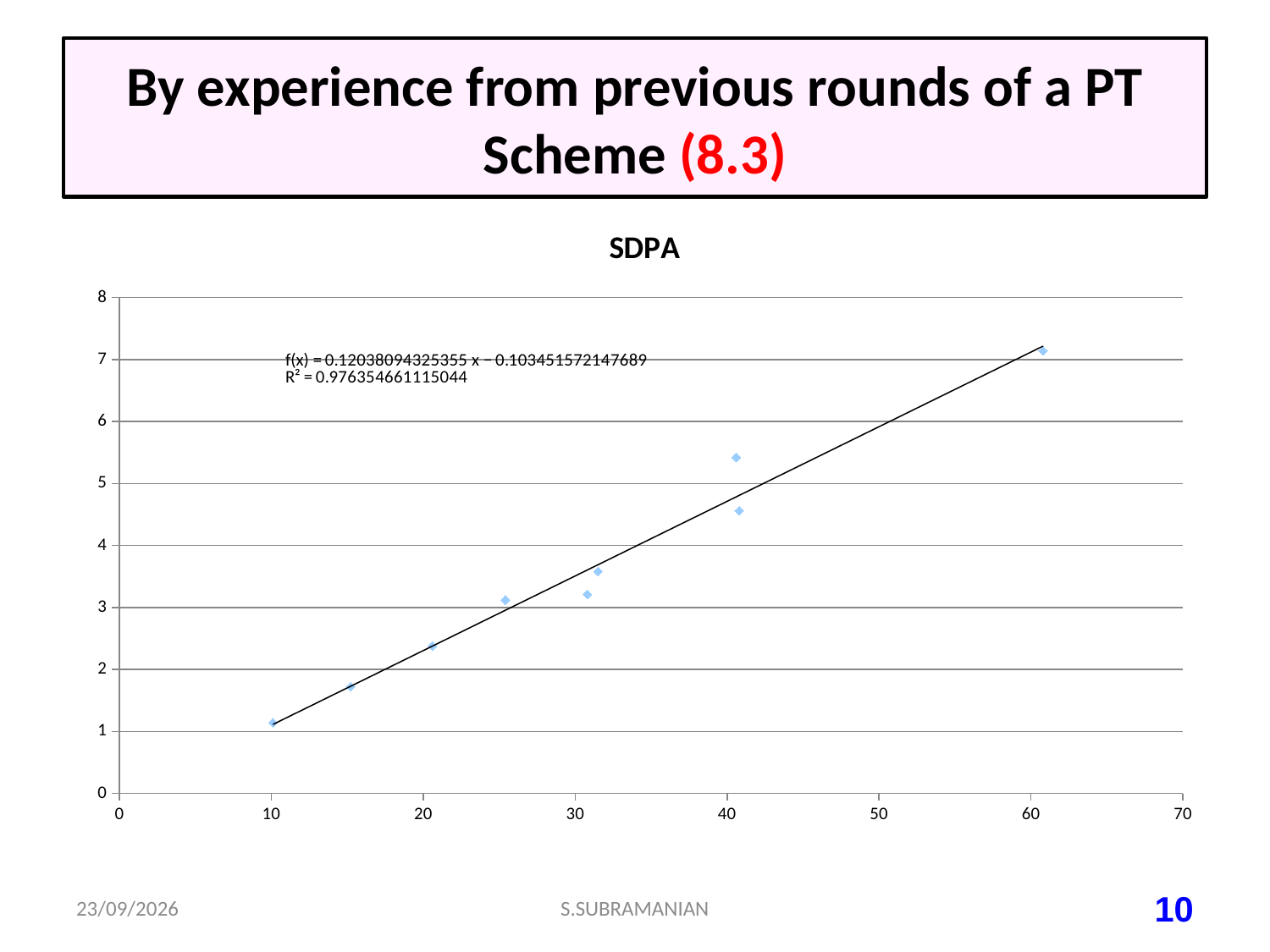
What is the trendline equation printed on the chart? f(x) = 0.12038094325355 x − 0.103451572147689 How many data points are plotted on the chart? 9 Is the y value of the point near x = 20 greater or less than 2? greater What is the title of the chart? SDPA Is the y value of the point near x = 15 greater or less than 2? less What is the maximum value shown on the x axis? 70 Do the plotted values rise or fall as x increases along the x axis? rise What is the R² value printed on the chart? 0.976354661115044 Is the y value of the highest point near x = 40 greater or less than 5? greater What kind of chart is shown on the slide? scatter chart